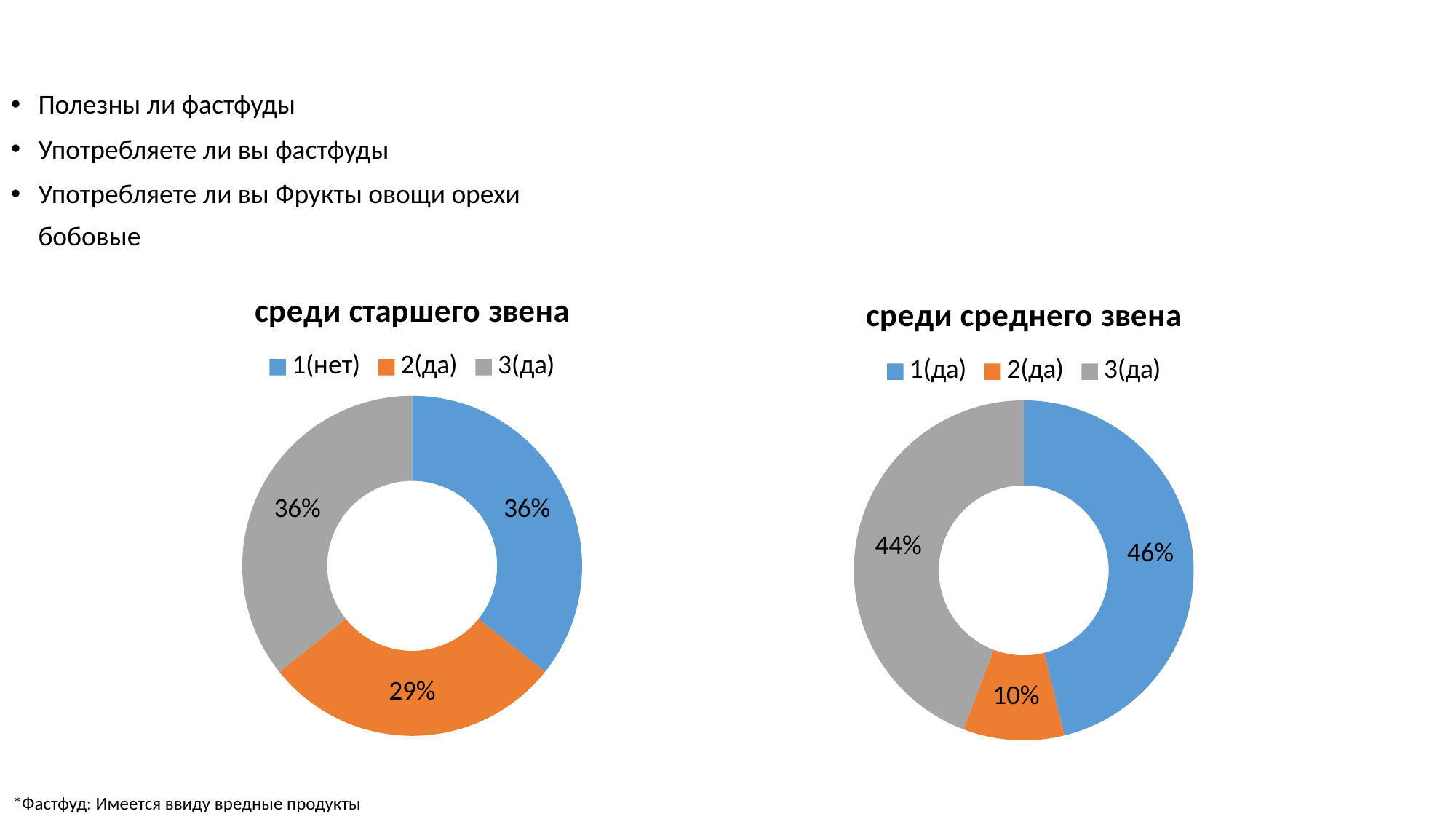
In the chart titled "среди среднего звена", what is the difference in percentage points between 1(да) and 2(да)? 36 In the chart titled "среди среднего звена", which category has the smallest share? 2(да) In the chart titled "среди старшего звена", which category has the smallest share? 2(да) What kind of chart is the chart titled "среди старшего звена"? doughnut chart In the chart titled "среди среднего звена", what percentage is shown for 1(да)? 46% In the chart titled "среди старшего звена", what percentage is shown for 1(нет)? 36% In the chart titled "среди среднего звена", which category has the largest share? 1(да) In the chart titled "среди среднего звена", what percentage is shown for 3(да)? 44% How many categories does the legend of the chart titled "среди среднего звена" list? 3 In the chart titled "среди старшего звена", which is larger: the share for 1(нет) or the share for 2(да)? 1(нет) In the chart titled "среди старшего звена", what percentage is shown for 2(да)? 29% In the chart titled "среди среднего звена", what percentage is shown for 2(да)? 10%